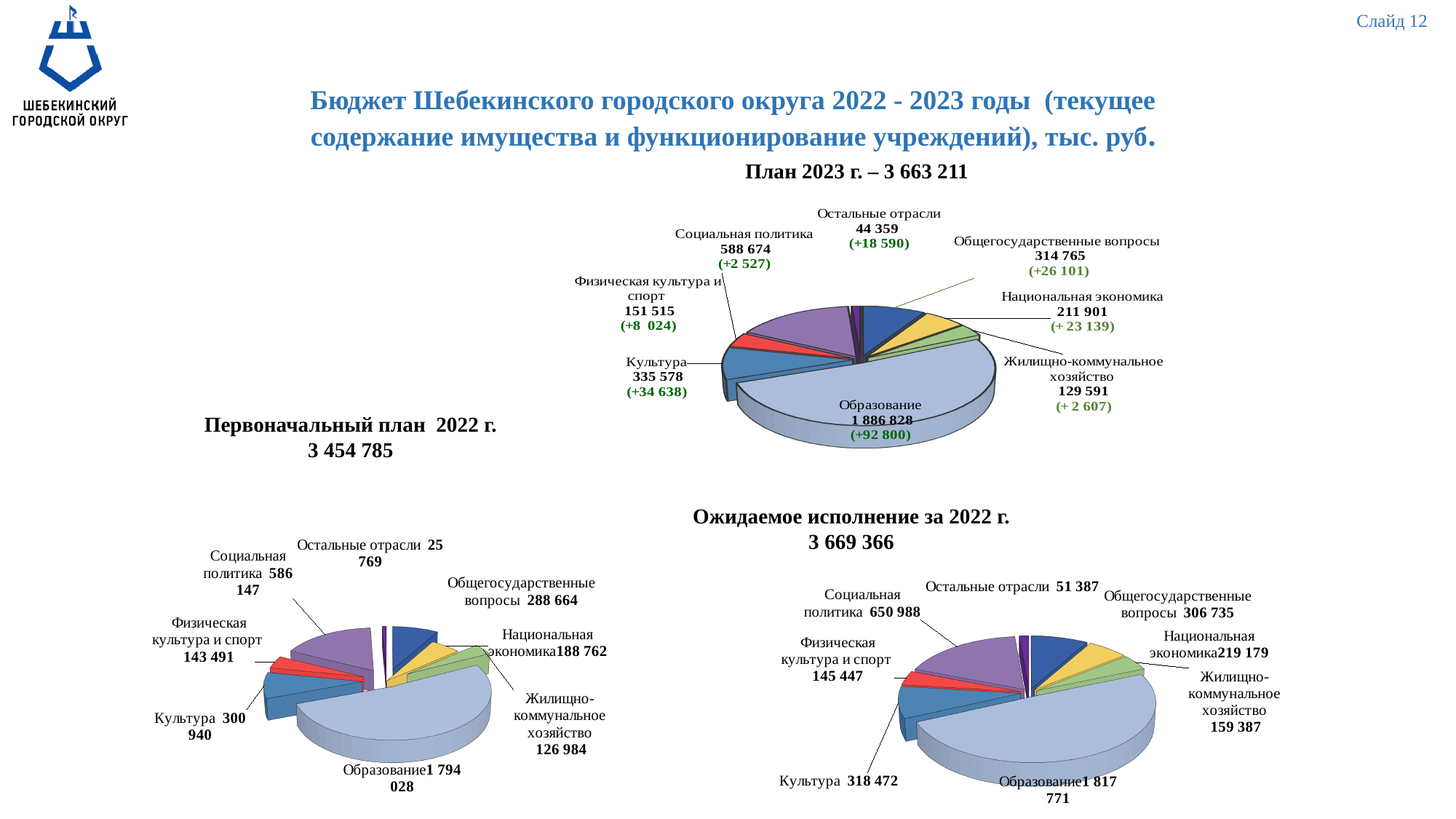
What total is shown for 'Ожидаемое исполнение за 2022 г.'? 3 669 366 In the 'Ожидаемое исполнение за 2022 г.' pie chart, which is larger: Общегосударственные вопросы or Национальная экономика? Общегосударственные вопросы In the 'План 2023 г.' pie chart, what change is shown in parentheses for Общегосударственные вопросы? +26 101 How many categories does the 'План 2023 г.' pie chart show? 8 In the 'Первоначальный план 2022 г.' pie chart, what is the value for Национальная экономика? 188 762 In the 'План 2023 г.' pie chart, what is the value for Образование? 1 886 828 What kind of chart is used for 'Первоначальный план 2022 г.'? Pie chart In the 'Ожидаемое исполнение за 2022 г.' pie chart, what is the value for Социальная политика? 650 988 In the 'План 2023 г.' pie chart, what is the value for Культура? 335 578 In the 'План 2023 г.' pie chart, what is the difference between Культура and Физическая культура и спорт? 184 063 In the 'Первоначальный план 2022 г.' pie chart, which category has the largest value? Образование In the 'Ожидаемое исполнение за 2022 г.' pie chart, which category has the smallest value? Остальные отрасли